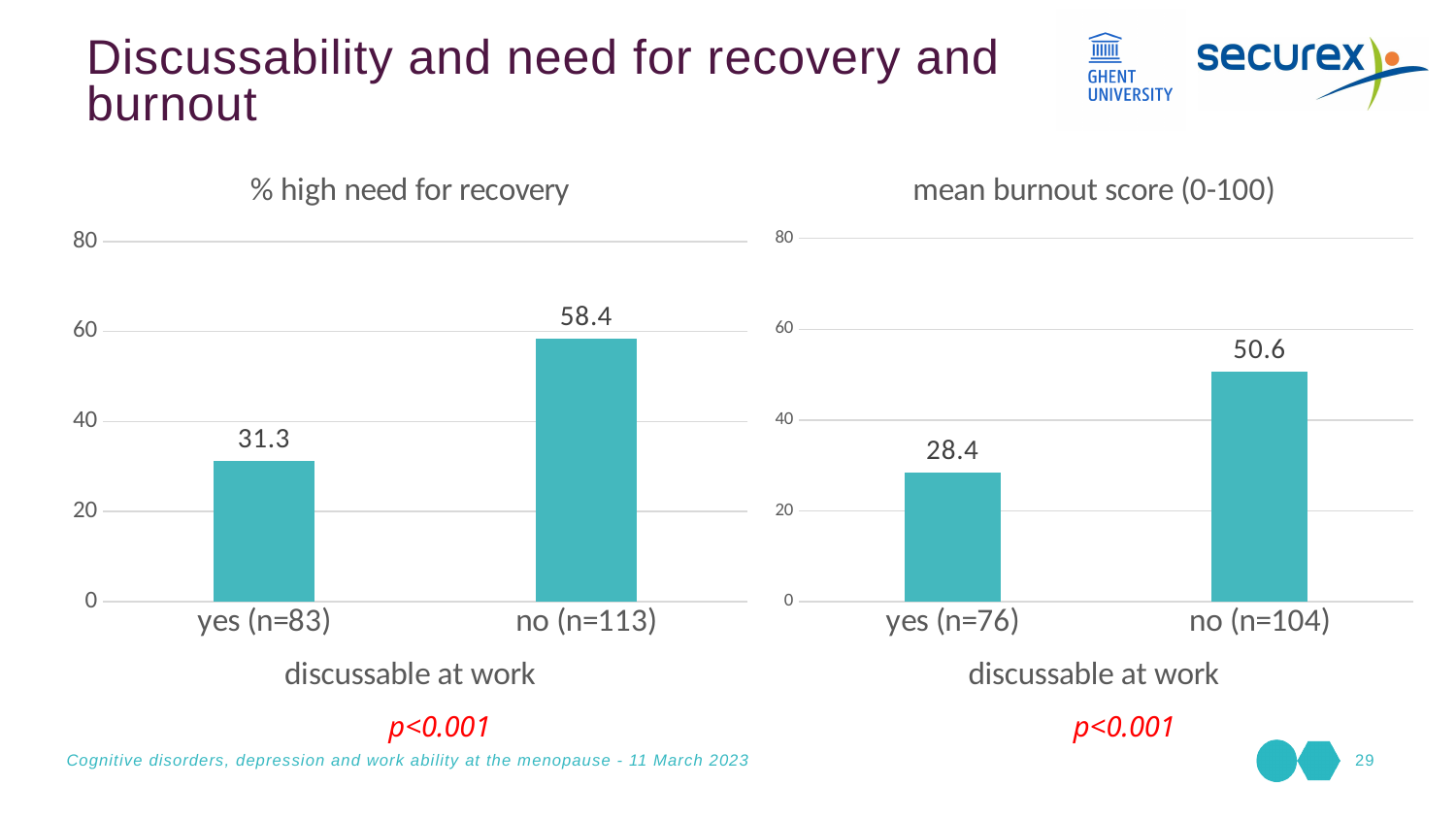
In the '% high need for recovery' chart, which category has the highest value? no (n=113) In the 'mean burnout score (0-100)' chart, what is the value for 'yes (n=76)'? 28.4 In the 'mean burnout score (0-100)' chart, what is the difference between the values for 'no (n=104)' and 'yes (n=76)'? 22.2 In the 'mean burnout score (0-100)' chart, which category has the lowest value? yes (n=76) What type of chart is the 'mean burnout score (0-100)' chart? bar chart In the '% high need for recovery' chart, what is the difference between the values for 'no (n=113)' and 'yes (n=83)'? 27.1 In the '% high need for recovery' chart, what is the value for 'no (n=113)'? 58.4 What is the x-axis title of the '% high need for recovery' chart? discussable at work In the 'mean burnout score (0-100)' chart, what is the value for 'no (n=104)'? 50.6 In the '% high need for recovery' chart, what is the value for 'yes (n=83)'? 31.3 In the 'mean burnout score (0-100)' chart, is the value for 'yes (n=76)' greater or less than 40? less How many categories are shown in the '% high need for recovery' chart? 2